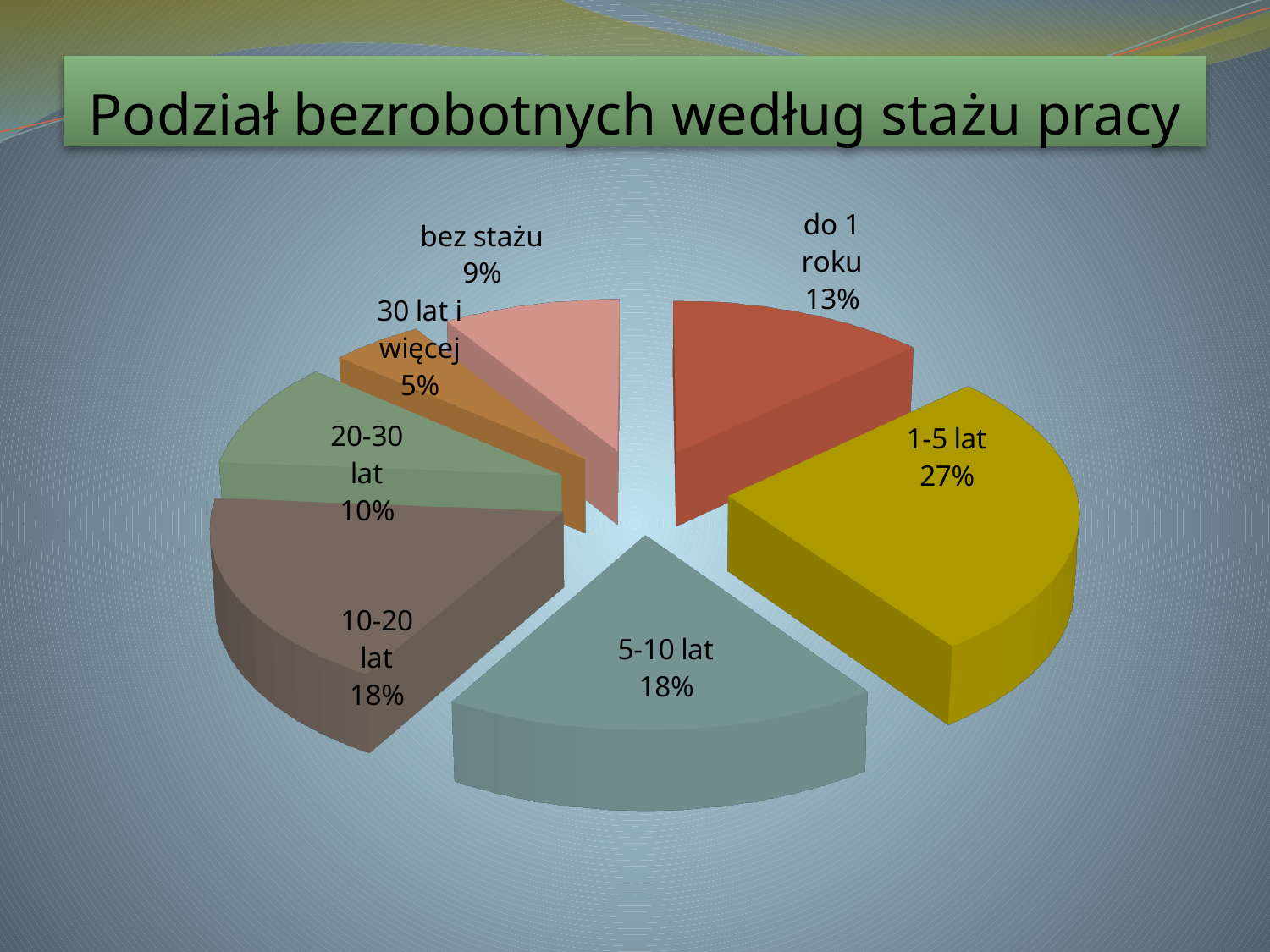
How many slices does the pie chart have? 7 What percentage is shown for 'do 1 roku'? 13% What percentage is shown for 'bez stażu'? 9% What is the title of the slide? Podział bezrobotnych według stażu pracy What percentage is shown for '30 lat i więcej'? 5% Which is larger, the share for 'do 1 roku' or the share for '20-30 lat'? do 1 roku Which category has the largest share of the pie? 1-5 lat What type of chart is shown on the slide? pie chart Which category has the smallest share of the pie? 30 lat i więcej What is the difference in percentage points between '1-5 lat' and '5-10 lat'? 9 What share of the pie does the '1-5 lat' slice represent? 27% What percentage is shown for '20-30 lat'? 10%